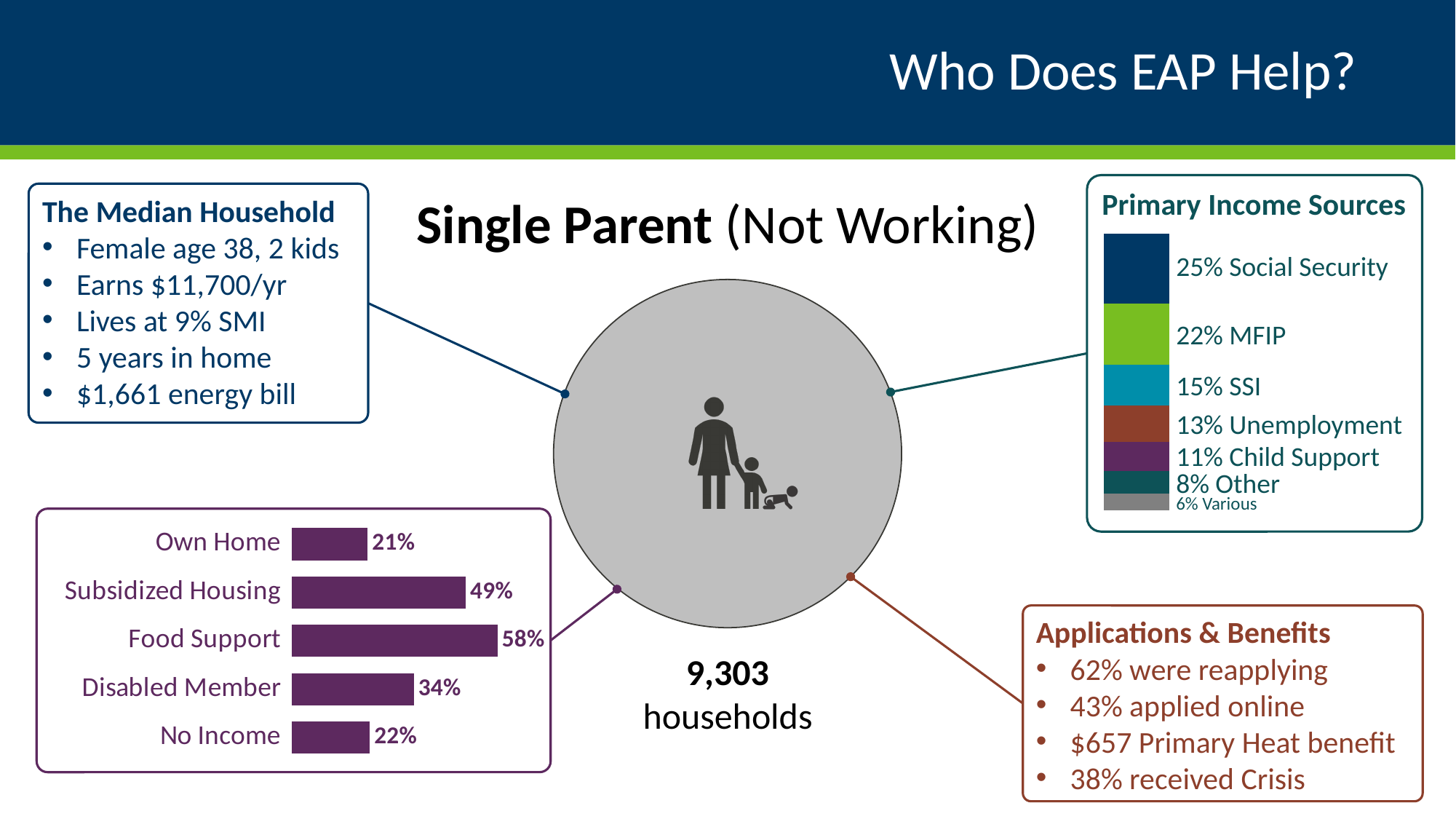
How many categories does the bottom-left bar chart show? 5 In the Primary Income Sources chart, what share is MFIP? 22% In the Primary Income Sources chart, which income source has the largest share? Social Security How many segments does the Primary Income Sources stacked bar have? 7 In the bottom-left bar chart, what is the difference between Subsidized Housing and Own Home? 28% In the bottom-left bar chart, which category has the lowest value? Own Home In the Primary Income Sources chart, what is the difference between SSI and Child Support? 4% What kind of chart is the bottom-left chart? Bar chart In the bottom-left bar chart, what is the value for Disabled Member? 34% In the bottom-left bar chart, which is larger, Disabled Member or No Income? Disabled Member In the bottom-left bar chart, what is the value for Food Support? 58% In the bottom-left bar chart, which category has the highest value? Food Support